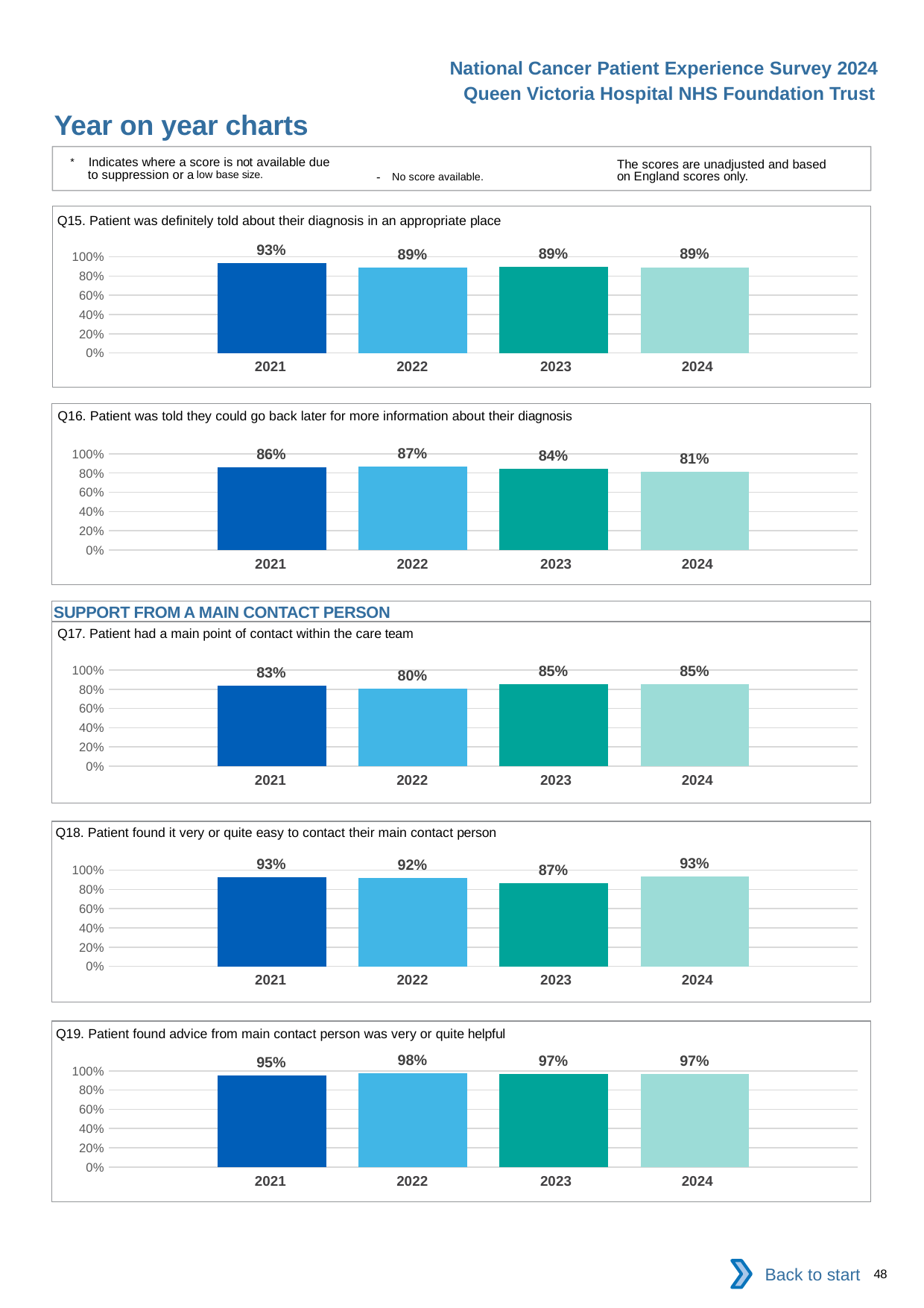
In the Q16 chart, what is the difference between the 2022 and 2024 values? 6 percentage points How many years are shown on the x axis of the Q15 chart? 4 In the Q18 chart, is the value for 2022 larger or smaller than the value for 2023? larger What type of chart is used for Q16? bar chart In the Q18 chart (patient found it very or quite easy to contact their main contact person), what is the value for 2023? 87% In the Q17 chart, which year has the lowest value? 2022 In the Q19 chart (patient found advice from main contact person was very or quite helpful), which year has the highest value? 2022 In the Q19 chart, what is the difference between the 2022 and 2021 values? 3 percentage points In the Q15 chart (patient was definitely told about their diagnosis in an appropriate place), what is the value for 2021? 93% In the Q16 chart, do the values rise or fall from 2022 to 2024? fall In the Q16 chart (patient was told they could go back later for more information), which year has the lowest value? 2024 In the Q17 chart (patient had a main point of contact within the care team), what is the value for 2022? 80%